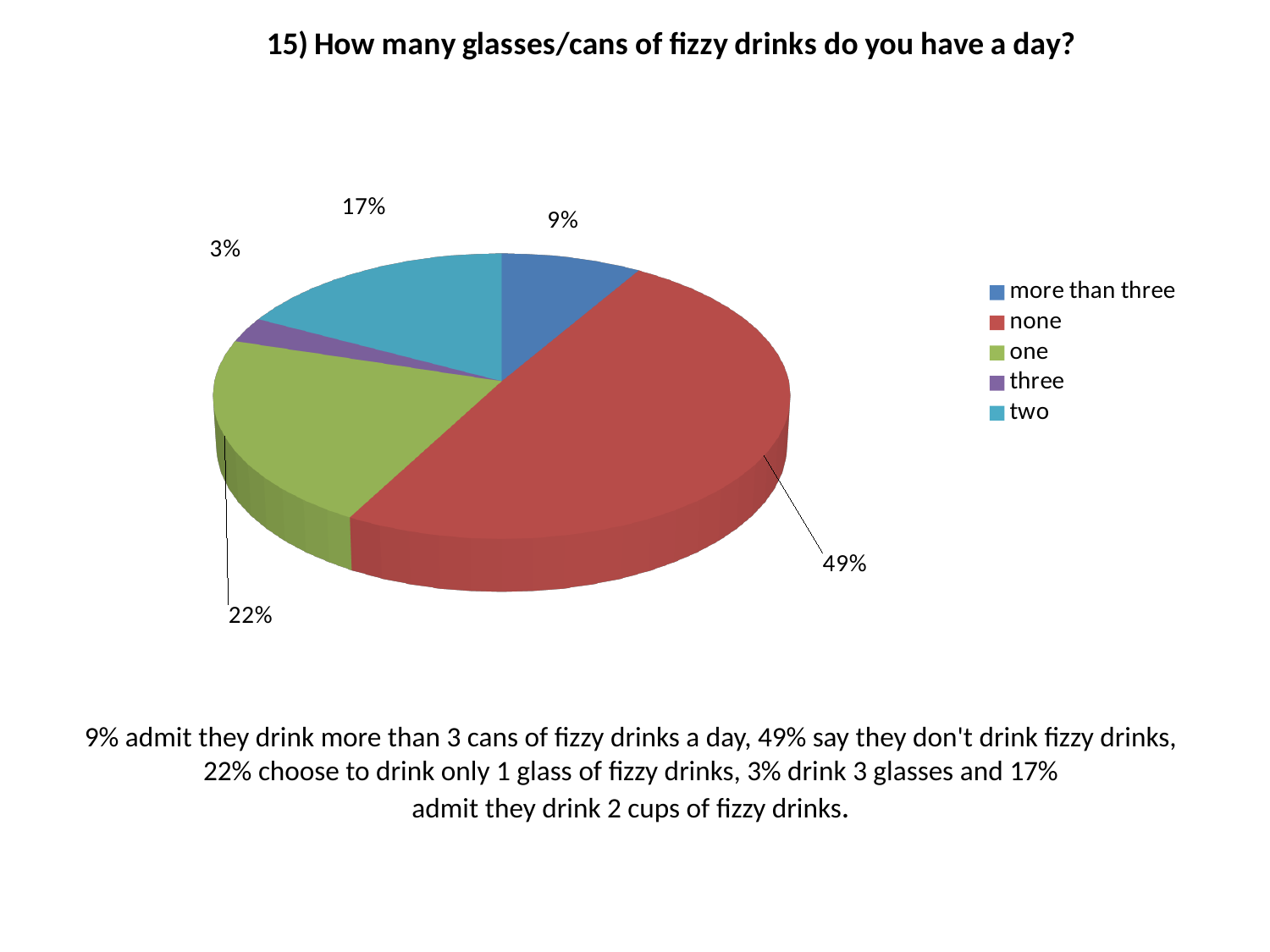
What percentage of respondents drink two glasses/cans of fizzy drinks a day? 17% What percentage of respondents drink more than three glasses/cans of fizzy drinks a day? 9% Which is larger, the share for 'two' or the share for 'more than three'? two Which category has the smallest share of the pie? three What percentage of respondents drink no fizzy drinks a day? 49% What is the difference in percentage points between the 'none' slice and the 'one' slice? 27 How many categories does the legend list? 5 What percentage of respondents drink three glasses/cans of fizzy drinks a day? 3% What percentage of respondents drink one glass/can of fizzy drinks a day? 22% What kind of chart is shown on the slide? pie chart What colour is the 'none' slice in the pie chart? red Which category has the largest share of the pie? none